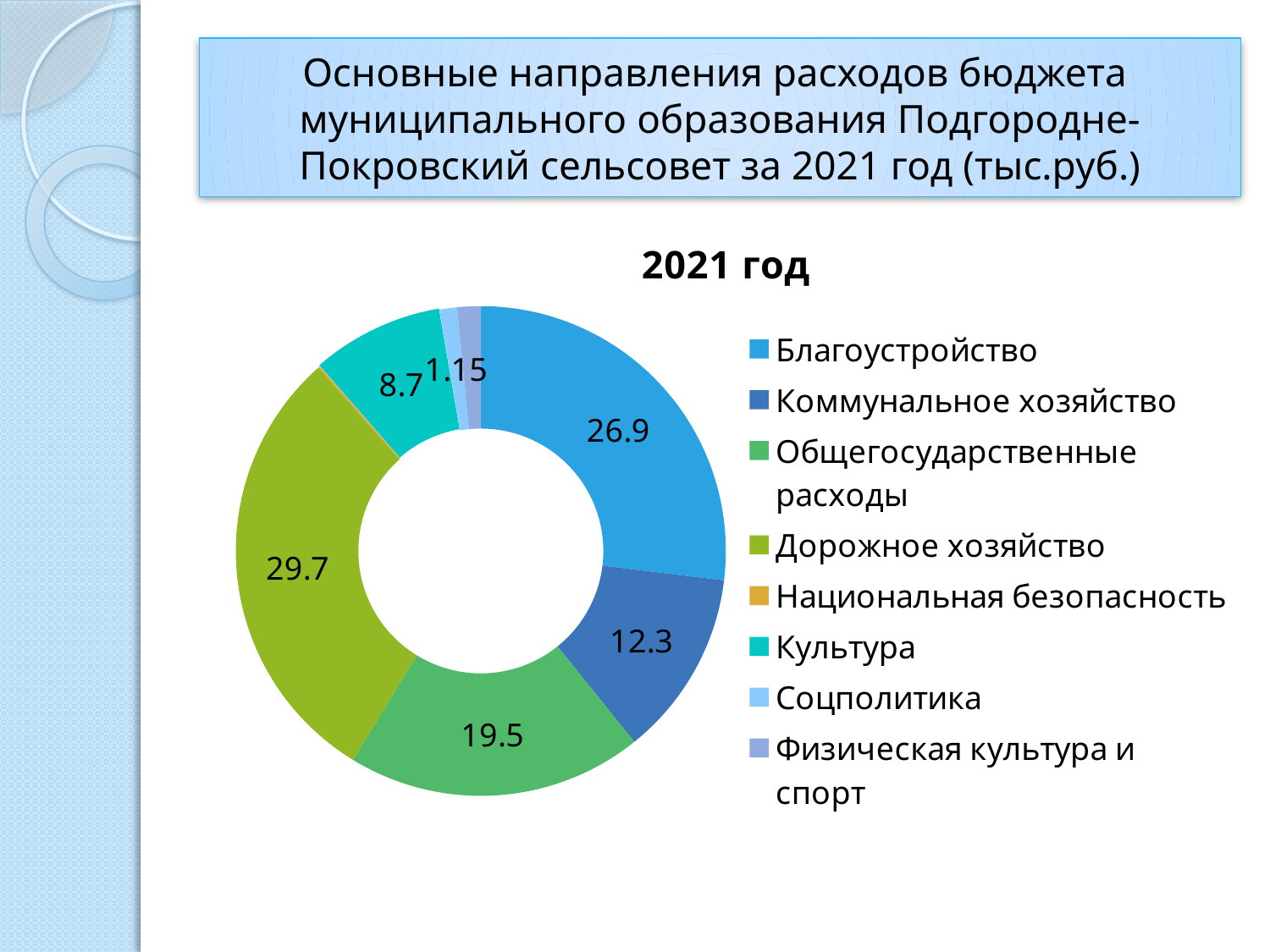
What is the value for Культура? 8.7 How many categories does the legend list? 8 What is the difference between the values for Дорожное хозяйство and Благоустройство? 2.8 Which category has the largest slice? Дорожное хозяйство What kind of chart is shown on the slide? Doughnut (pie) chart What is the difference between the values for Общегосударственные расходы and Коммунальное хозяйство? 7.2 What is the value for Общегосударственные расходы? 19.5 What is the value for Коммунальное хозяйство? 12.3 Which is larger, the value for Благоустройство or the value for Общегосударственные расходы? Благоустройство What is the title of the chart? 2021 год What is the value for Благоустройство? 26.9 What is the value for Дорожное хозяйство? 29.7